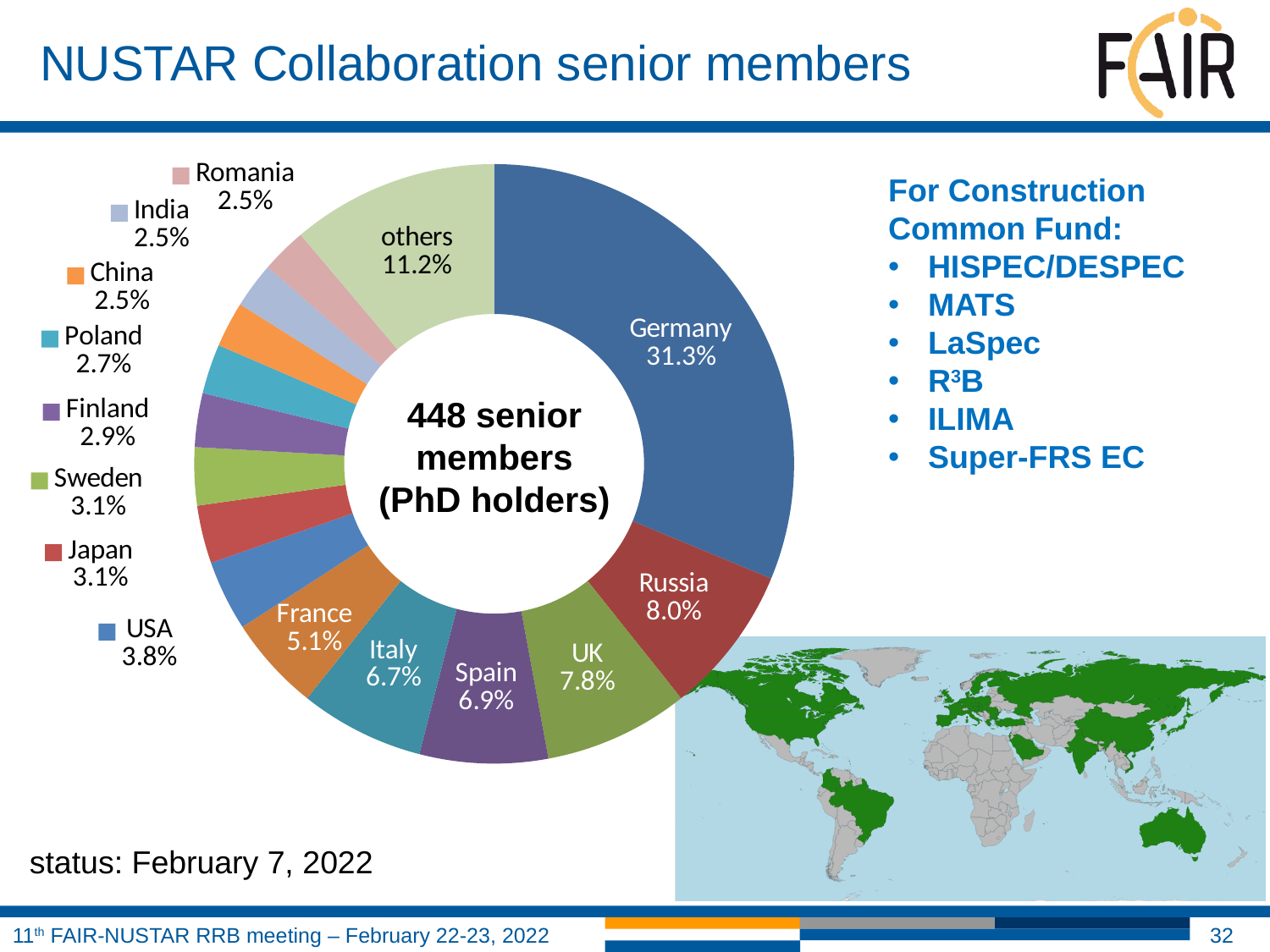
How many slices does the chart have, including 'others'? 15 What kind of chart is shown on the slide? Pie (doughnut) chart What share of senior members is from Germany? 31.3% Which has a larger share, the UK or Spain? UK What percentage of senior members is from Russia? 8.0% What total number of senior members is stated in the centre of the chart? 448 What percentage is labelled for Poland? 2.7% What is the difference between Germany's share and Russia's share? 23.3% Which has a larger share, France or Italy? Italy Which country has the largest share of senior members? Germany What is the share for the UK? 7.8% What is the share of the 'others' slice? 11.2%